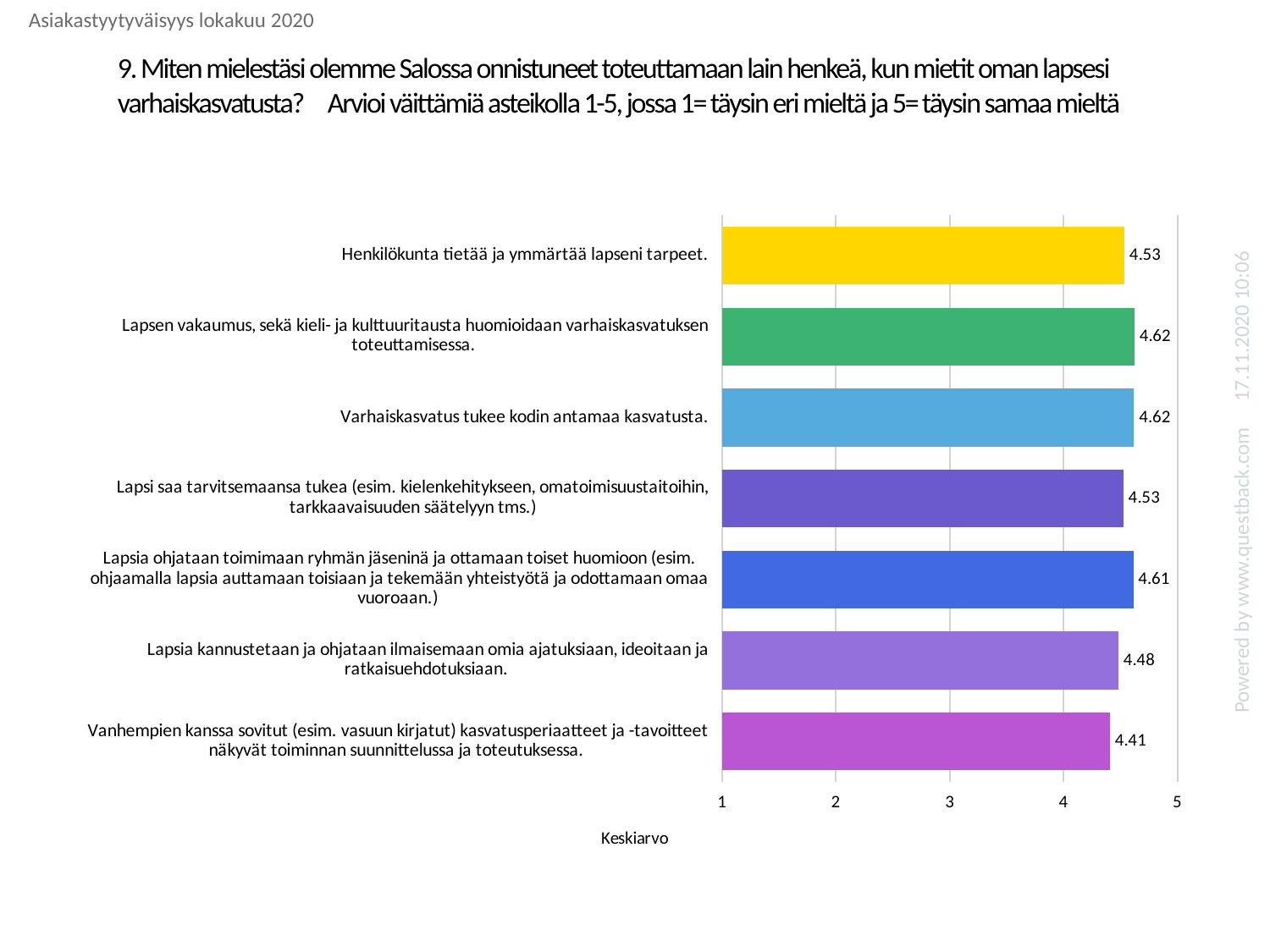
What is the difference between the value for "Varhaiskasvatus tukee kodin antamaa kasvatusta." and the value for the statement about "Vanhempien kanssa sovitut" kasvatusperiaatteet? 0.21 What is the label on the horizontal axis of the chart? Keskiarvo Which has a larger value: "Henkilökunta tietää ja ymmärtää lapseni tarpeet." or "Lapsia kannustetaan ja ohjataan ilmaisemaan omia ajatuksiaan, ideoitaan ja ratkaisuehdotuksiaan."? Henkilökunta tietää ja ymmärtää lapseni tarpeet. What is the value for "Henkilökunta tietää ja ymmärtää lapseni tarpeet."? 4.53 What is the value for the statement about "Vanhempien kanssa sovitut (esim. vasuun kirjatut) kasvatusperiaatteet ja -tavoitteet"? 4.41 Is the value for "Lapsia ohjataan toimimaan ryhmän jäseninä ja ottamaan toiset huomioon" greater or less than 4? greater What is the value for "Lapsia ohjataan toimimaan ryhmän jäseninä ja ottamaan toiset huomioon"? 4.61 How many statements (bars) are shown in the chart? 7 Which statement has the lowest value? Vanhempien kanssa sovitut (esim. vasuun kirjatut) kasvatusperiaatteet ja -tavoitteet näkyvät toiminnan suunnittelussa ja toteutuksessa. What kind of chart is shown on the slide? bar chart What is the value for "Varhaiskasvatus tukee kodin antamaa kasvatusta."? 4.62 What is the value for "Lapsia kannustetaan ja ohjataan ilmaisemaan omia ajatuksiaan, ideoitaan ja ratkaisuehdotuksiaan."? 4.48